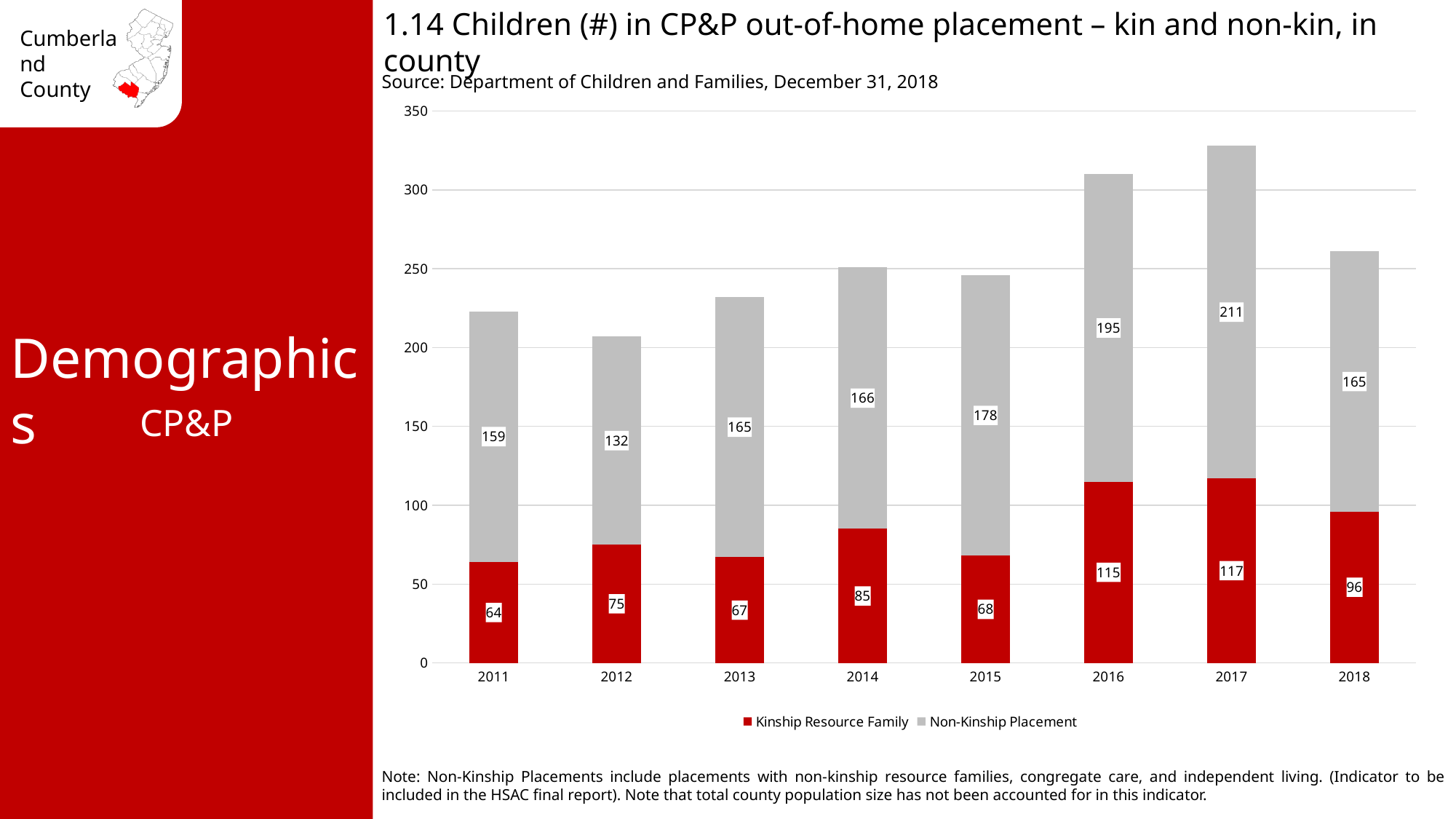
What is the total of the stacked bar for 2017? 328 Is the total of the stacked bar for 2012 greater or less than 250? less Which year has the highest Non-Kinship Placement value? 2017 Which year has the lowest Kinship Resource Family value? 2011 How many series does the legend list? 2 What is the Non-Kinship Placement value for 2015? 178 How many years are shown on the x axis? 8 What type of chart is shown on the slide? Stacked bar chart What is the Kinship Resource Family value for 2016? 115 Which is larger, the Kinship Resource Family value for 2014 or for 2018? 2018 What is the difference between the Non-Kinship Placement values for 2017 and 2018? 46 What colour represents Kinship Resource Family in the chart? Red